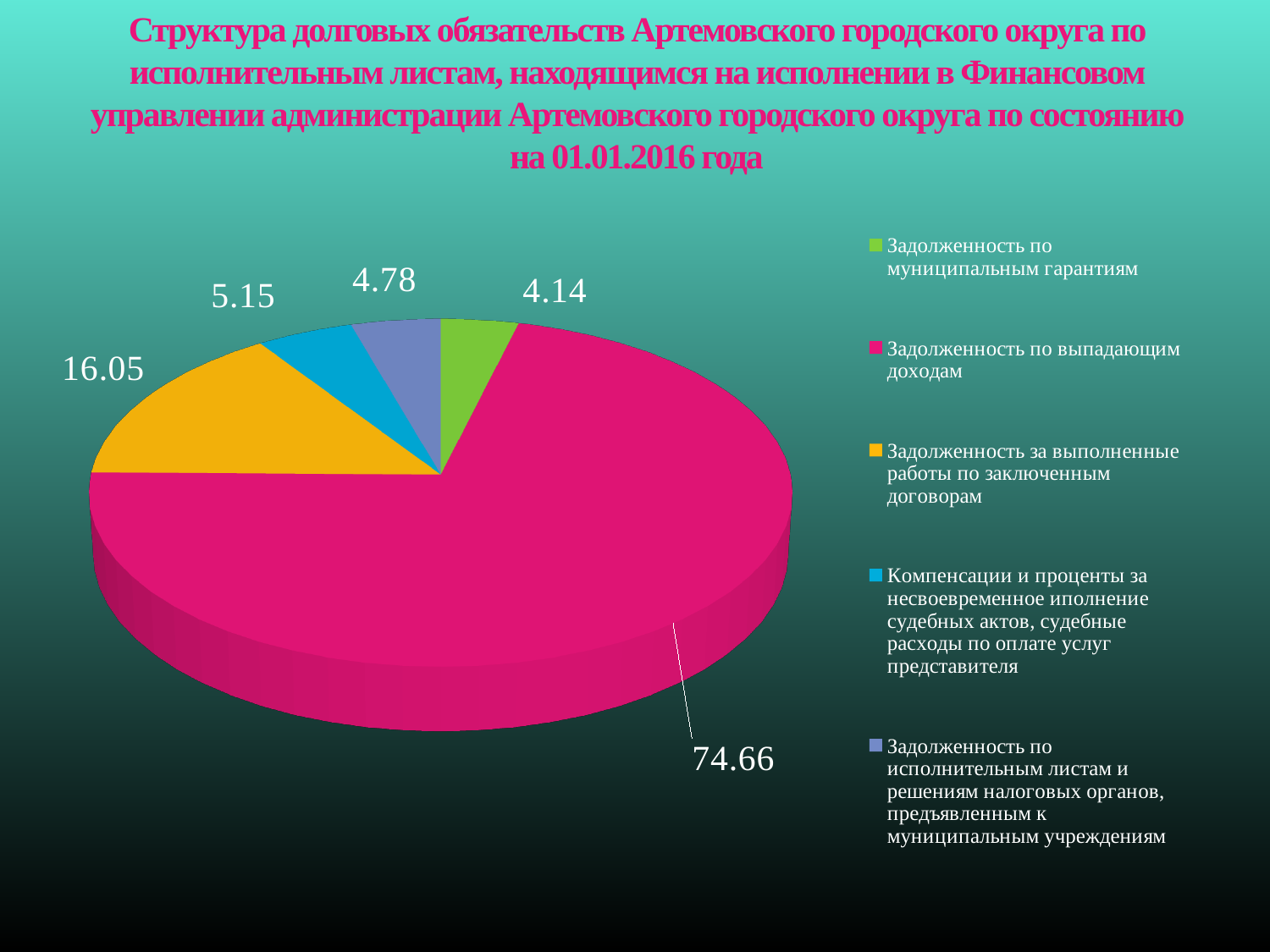
What is the value for "Задолженность за выполненные работы по заключенным договорам"? 16.05 Which category has the smallest slice of the pie? Задолженность по муниципальным гарантиям What is the value for "Задолженность по выпадающим доходам"? 74.66 What colour is the slice for "Задолженность за выполненные работы по заключенным договорам"? Orange Which is larger: the value for "Компенсации и проценты за несвоевременное иполнение судебных актов..." or the value for "Задолженность по исполнительным листам и решениям налоговых органов..."? Компенсации и проценты за несвоевременное иполнение судебных актов, судебные расходы по оплате услуг представителя What is the value for "Компенсации и проценты за несвоевременное иполнение судебных актов, судебные расходы по оплате услуг представителя"? 5.15 What is the difference between the values for "Задолженность по выпадающим доходам" and "Задолженность за выполненные работы по заключенным договорам"? 58.61 What is the value for "Задолженность по исполнительным листам и решениям налоговых органов, предъявленным к муниципальным учреждениям"? 4.78 What is the value for "Задолженность по муниципальным гарантиям"? 4.14 Which category has the largest slice of the pie? Задолженность по выпадающим доходам How many slices does the pie chart have? 5 What kind of chart is shown on the slide? Pie chart